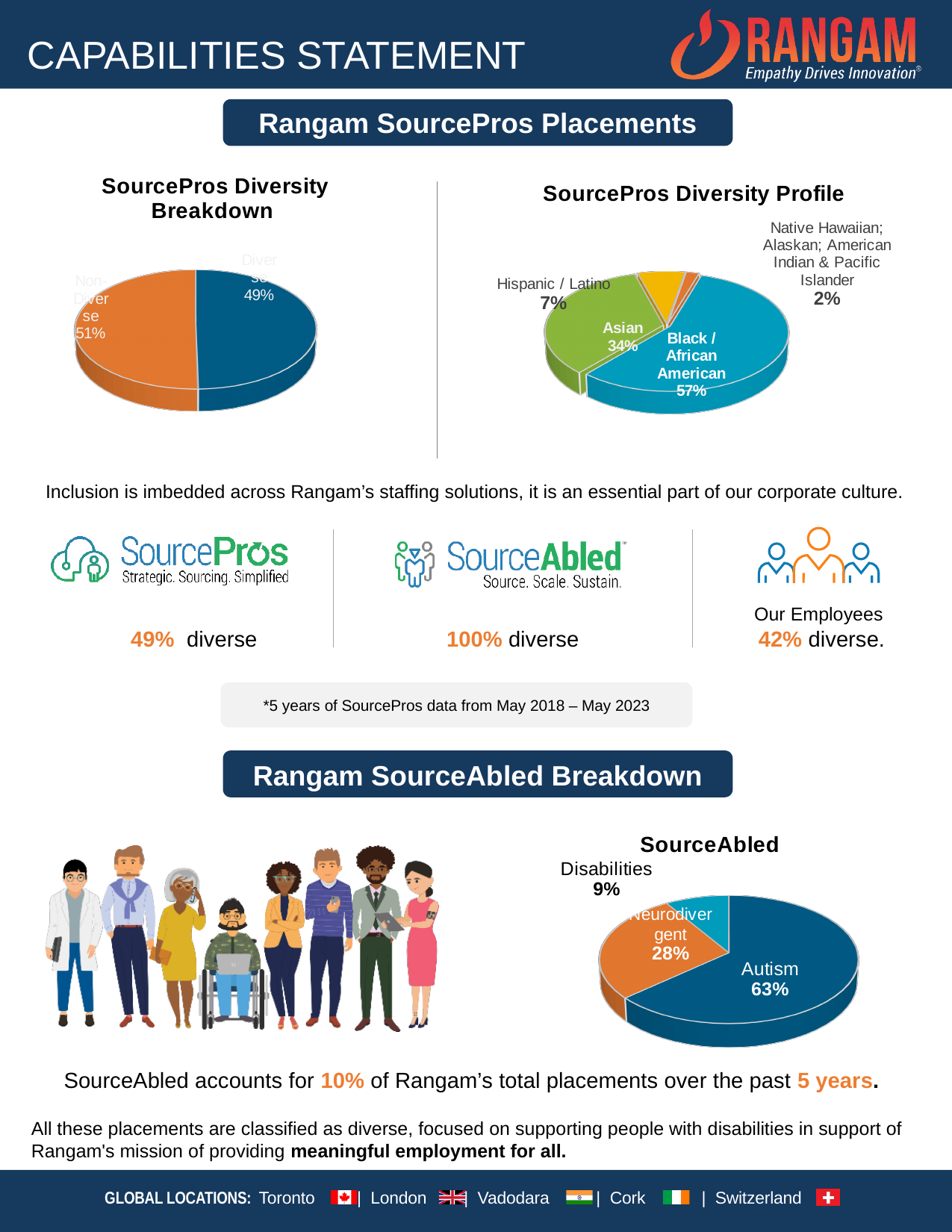
In the SourcePros Diversity Profile chart, what is the difference between the Black / African American share and the Asian share? 23% In the SourceAbled chart, which is larger, Neurodivergent or Disabilities? Neurodivergent In the SourcePros Diversity Profile chart, which category has the largest share? Black / African American In the SourcePros Diversity Profile chart, what share is Hispanic / Latino? 7% In the SourcePros Diversity Profile chart, which category has the smallest share? Native Hawaiian; Alaskan; American Indian & Pacific Islander In the SourceAbled chart, what share is Autism? 63% In the SourcePros Diversity Profile chart, how many categories are shown? 4 In the SourcePros Diversity Profile chart, what share is Black / African American? 57% In the SourcePros Diversity Profile chart, what share is Asian? 34% In the SourceAbled chart, what is the difference between the Autism share and the Neurodivergent share? 35% What type of chart is the SourcePros Diversity Breakdown chart? Pie chart In the SourcePros Diversity Breakdown chart, what share is Non-Diverse? 51%